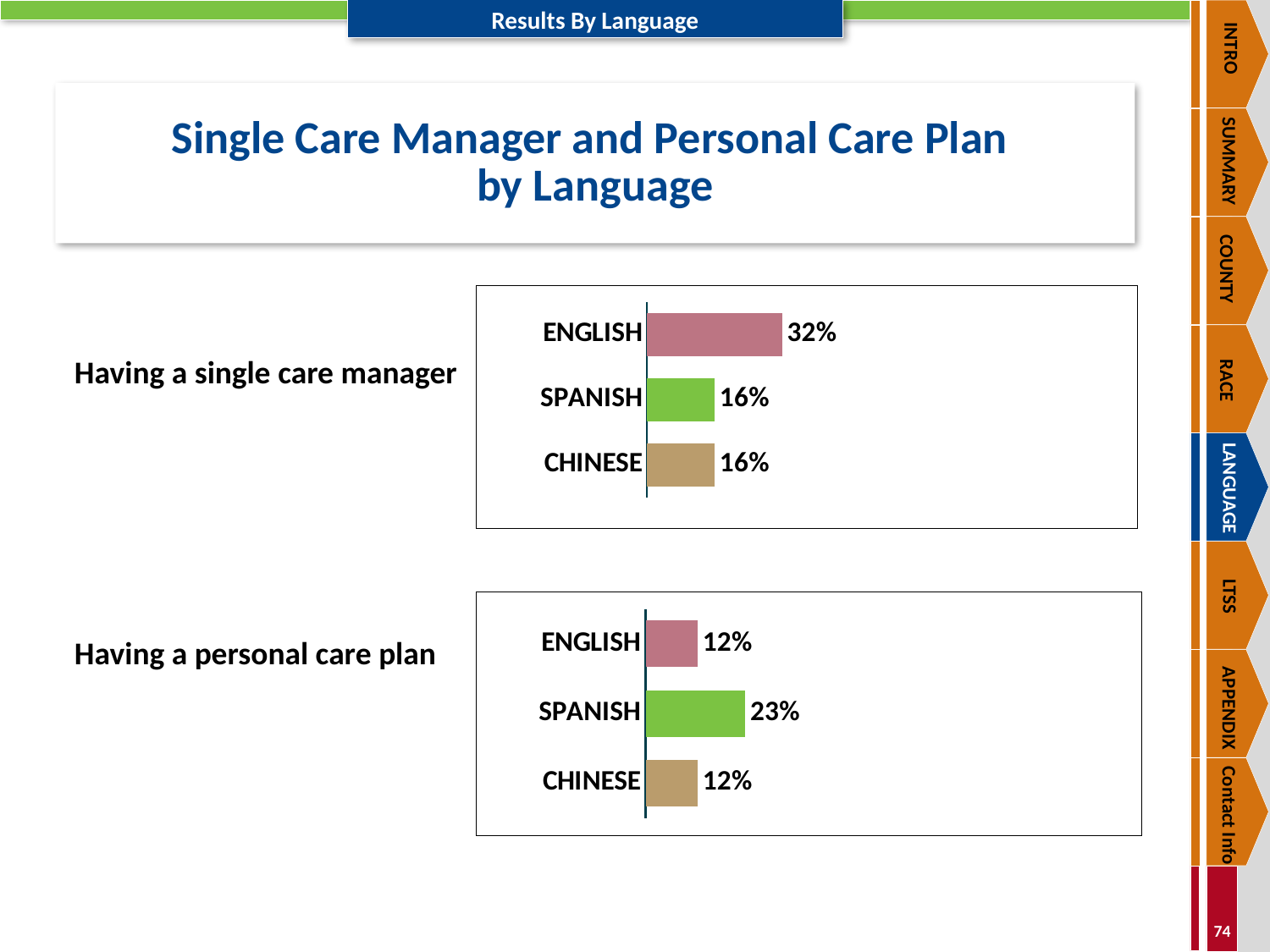
How many language categories are shown in the 'Having a single care manager' chart? 3 In the 'Having a personal care plan' chart, which language has the highest value? SPANISH In the 'Having a single care manager' chart, what is the difference between the ENGLISH and SPANISH values? 16% What kind of chart is the 'Having a personal care plan' chart? Bar chart In the 'Having a single care manager' chart, which language has the highest value? ENGLISH In the 'Having a personal care plan' chart, which is larger, the value for SPANISH or the value for CHINESE? SPANISH In the 'Having a personal care plan' chart, what is the difference between the SPANISH and ENGLISH values? 11% In the 'Having a single care manager' chart, what is the value for ENGLISH? 32% What is the title of the slide's main heading above the charts? Single Care Manager and Personal Care Plan by Language In the 'Having a single care manager' chart, what is the value for SPANISH? 16% In the 'Having a personal care plan' chart, what is the value for SPANISH? 23% In the 'Having a personal care plan' chart, what is the value for CHINESE? 12%